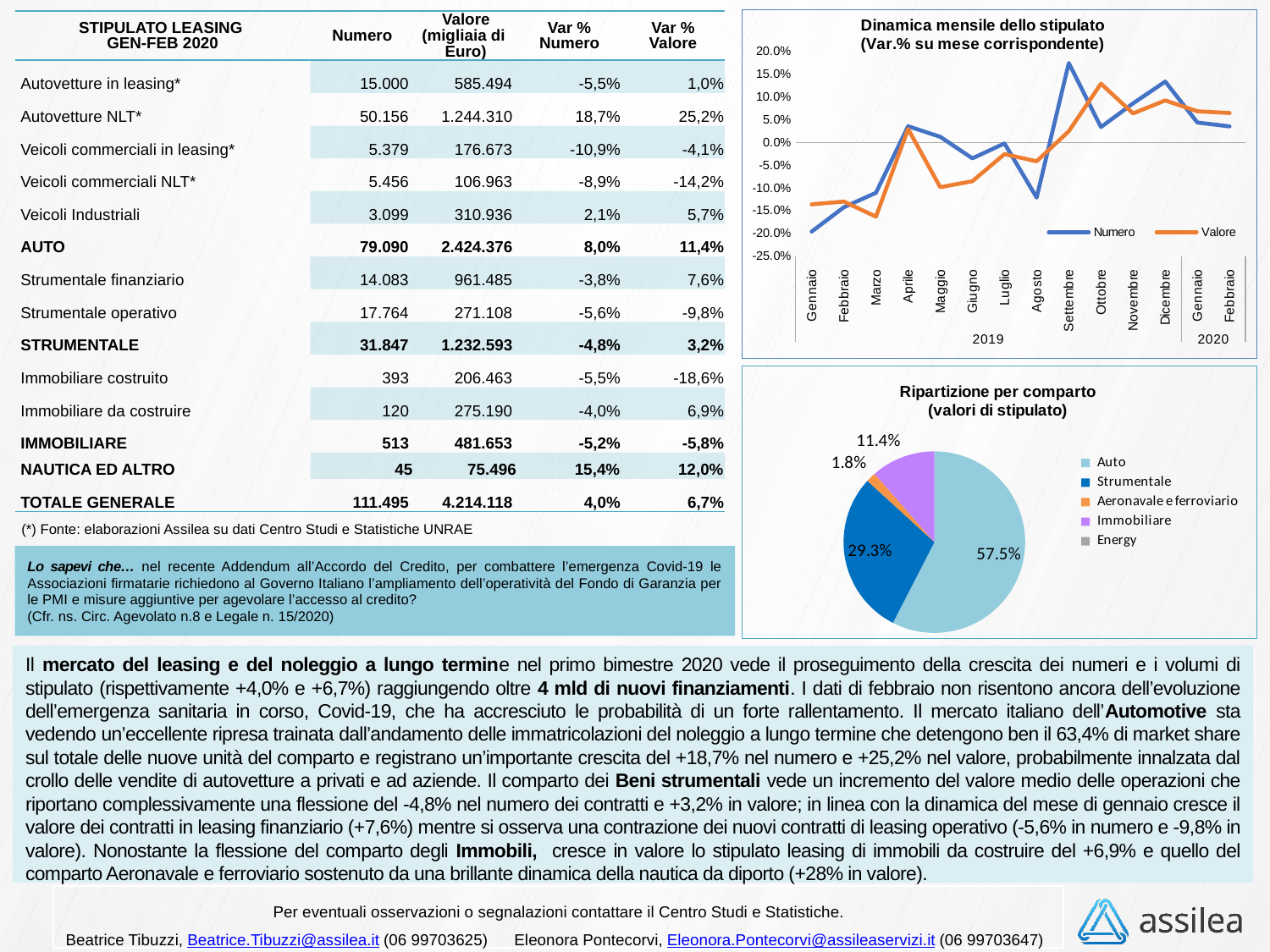
What kind of chart is 'Dinamica mensile dello stipulato'? Line chart How many entries does the legend of the pie chart 'Ripartizione per comparto' list? 5 In the pie chart 'Ripartizione per comparto', what share does Auto have? 57.5% In the pie chart 'Ripartizione per comparto', which comparto has the largest slice? Auto In the pie chart 'Ripartizione per comparto', what share does Strumentale have? 29.3% How many series does the legend of the line chart 'Dinamica mensile dello stipulato' list? 2 In the line chart 'Dinamica mensile dello stipulato', is the Numero value for Gennaio 2019 greater or less than -15.0%? less In the pie chart 'Ripartizione per comparto', what share does Immobiliare have? 11.4% In the line chart 'Dinamica mensile dello stipulato', in which month does the Numero series reach its highest value? Settembre 2019 In the line chart 'Dinamica mensile dello stipulato', is the Valore value for Ottobre 2019 greater or less than 10.0%? greater In the pie chart 'Ripartizione per comparto', what is the difference in percentage points between the Auto and Strumentale shares? 28.2 percentage points In the pie chart 'Ripartizione per comparto', which is larger, the Immobiliare share or the Aeronavale e ferroviario share? Immobiliare